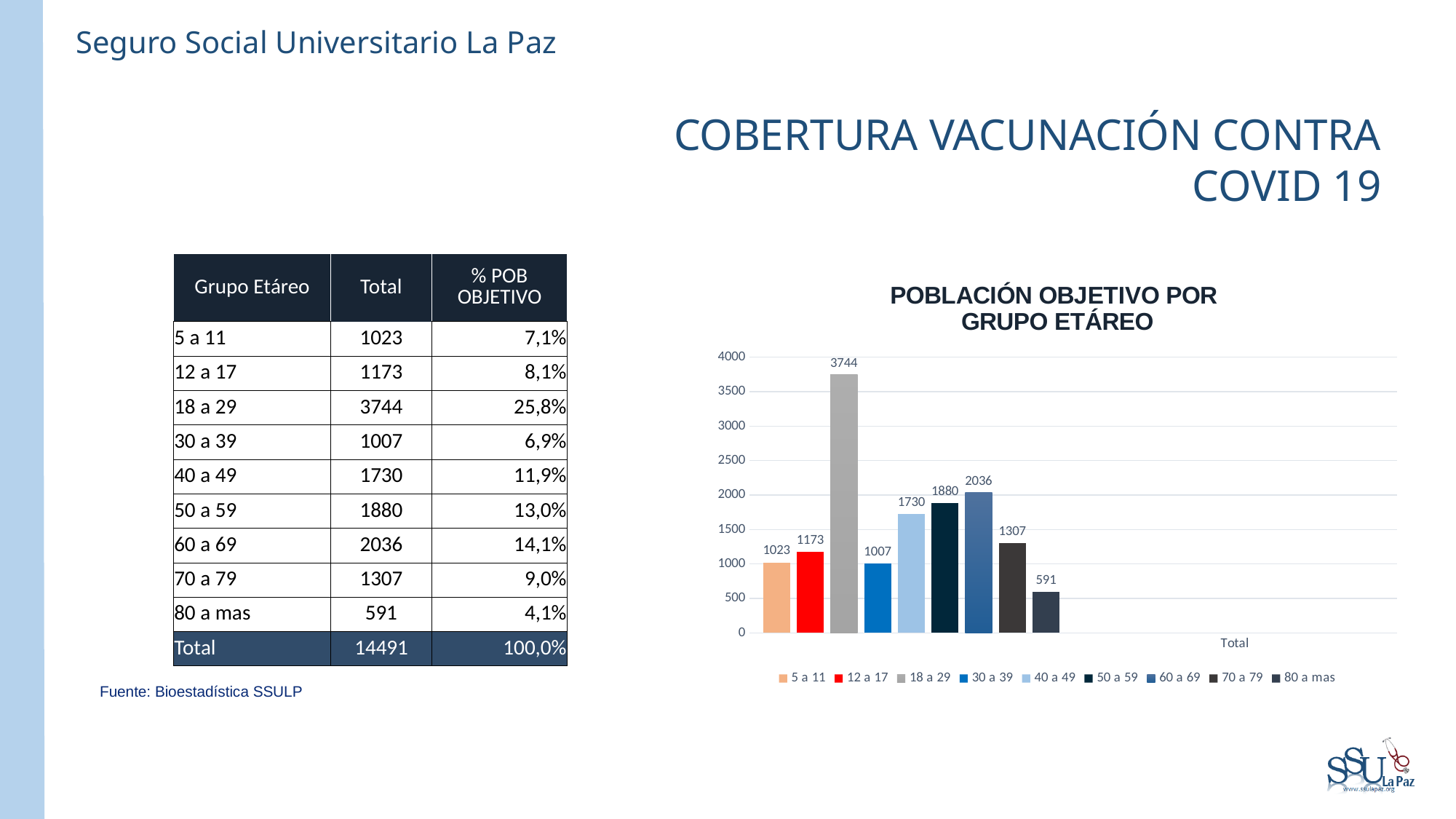
How many entries does the chart legend list? 9 Which age group has the highest value in the chart? 18 a 29 How many age groups are plotted in the chart? 9 What is the value for the 18 a 29 group in the chart? 3744 Is the value for 70 a 79 greater or less than 1500? less Which is larger, the value for 12 a 17 or the value for 30 a 39? 12 a 17 What kind of chart is shown on the slide? bar chart What is the value for the 60 a 69 group in the chart? 2036 What is the difference between the values for 50 a 59 and 40 a 49? 150 What is the value for the 80 a mas group in the chart? 591 What is the title of the chart? POBLACIÓN OBJETIVO POR GRUPO ETÁREO Which age group has the lowest value in the chart? 80 a mas